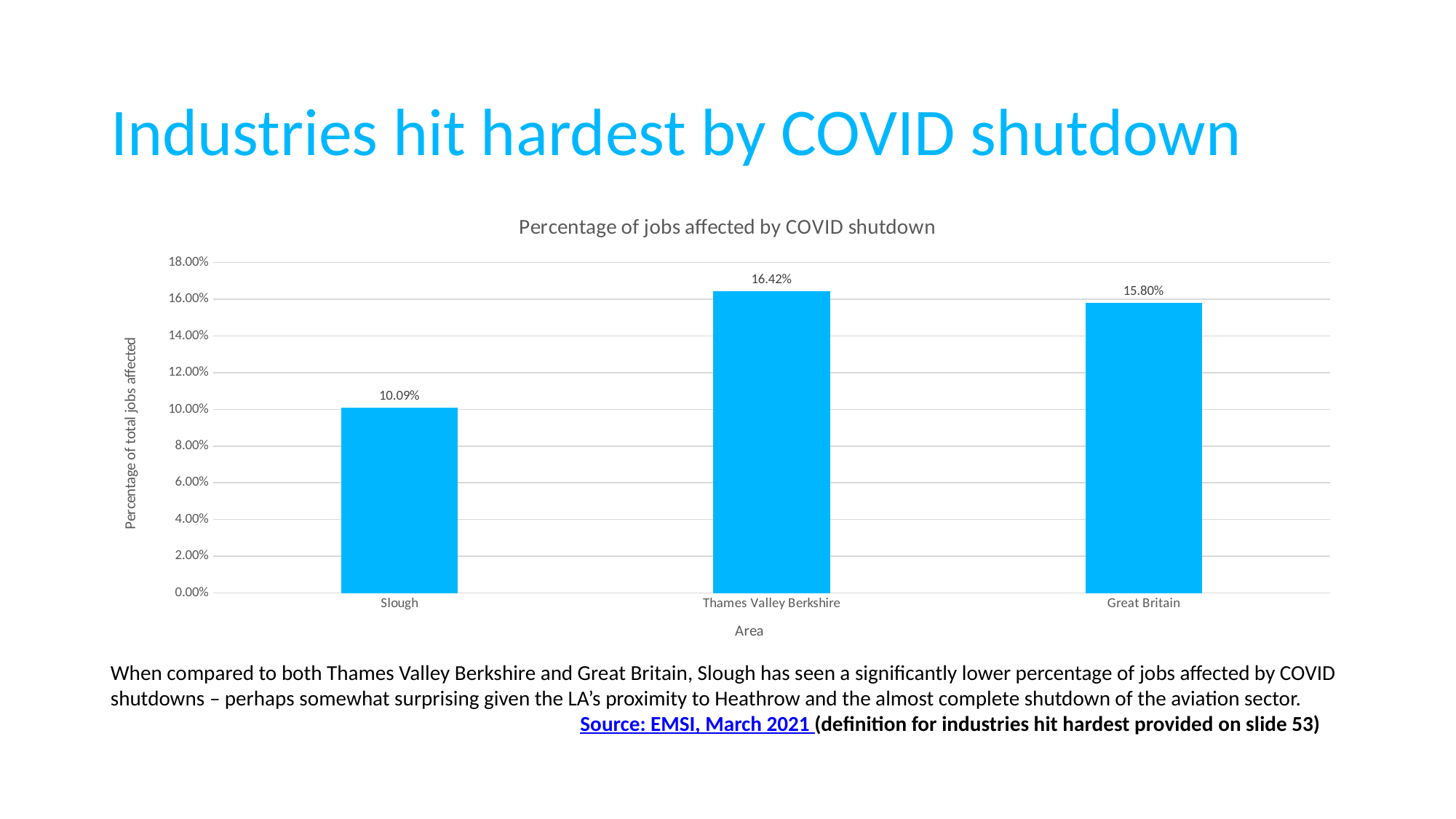
What is the percentage of jobs affected by COVID shutdown for Great Britain? 15.80% Which area has the highest percentage of jobs affected by COVID shutdown? Thames Valley Berkshire What kind of chart is shown on the slide? Bar chart What is the percentage of jobs affected by COVID shutdown for Slough? 10.09% What is the difference between the percentage of jobs affected in Thames Valley Berkshire and in Slough? 6.33% What is the percentage of jobs affected by COVID shutdown for Thames Valley Berkshire? 16.42% Which has a higher percentage of jobs affected by COVID shutdown, Slough or Great Britain? Great Britain Which area has the lowest percentage of jobs affected by COVID shutdown? Slough What is the title of the chart? Percentage of jobs affected by COVID shutdown How many areas are shown in the chart? 3 What is the difference between the percentage of jobs affected in Thames Valley Berkshire and in Great Britain? 0.62% Is the value for Slough greater or less than 12.00%? less